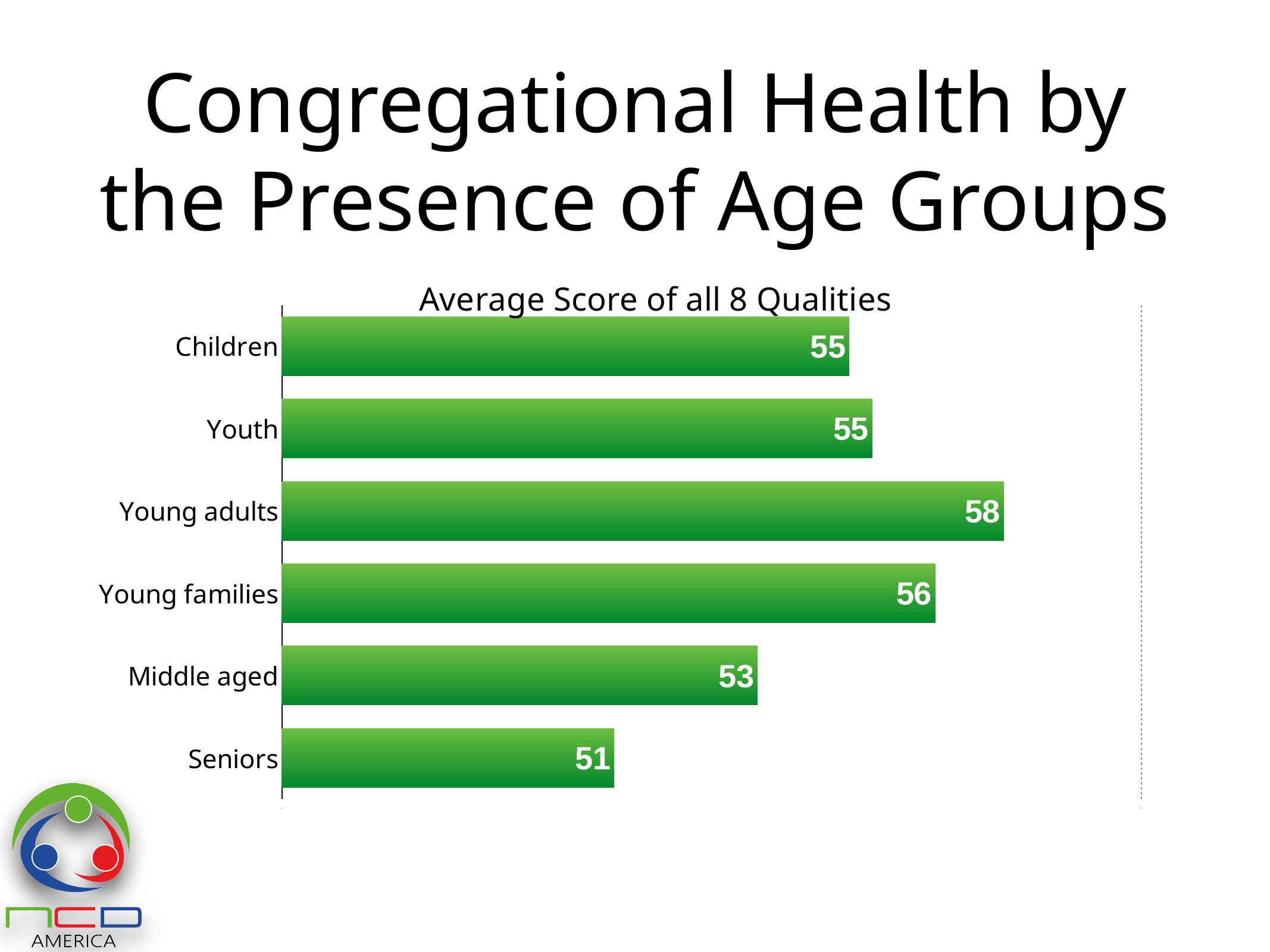
What kind of chart is shown on the slide? Bar chart Which age group has the highest average score? Young adults What is the difference between the average scores for Young adults and Seniors? 7 What is the average score for Middle aged? 53 How many age groups are shown in the chart? 6 What is the average score for Young adults? 58 What is the difference between the average scores for Young families and Middle aged? 3 Which age group has the lowest average score? Seniors Which has a higher average score, Young families or Middle aged? Young families What is the average score for Young families? 56 What is the average score for Seniors? 51 What is the title of the chart? Average Score of all 8 Qualities